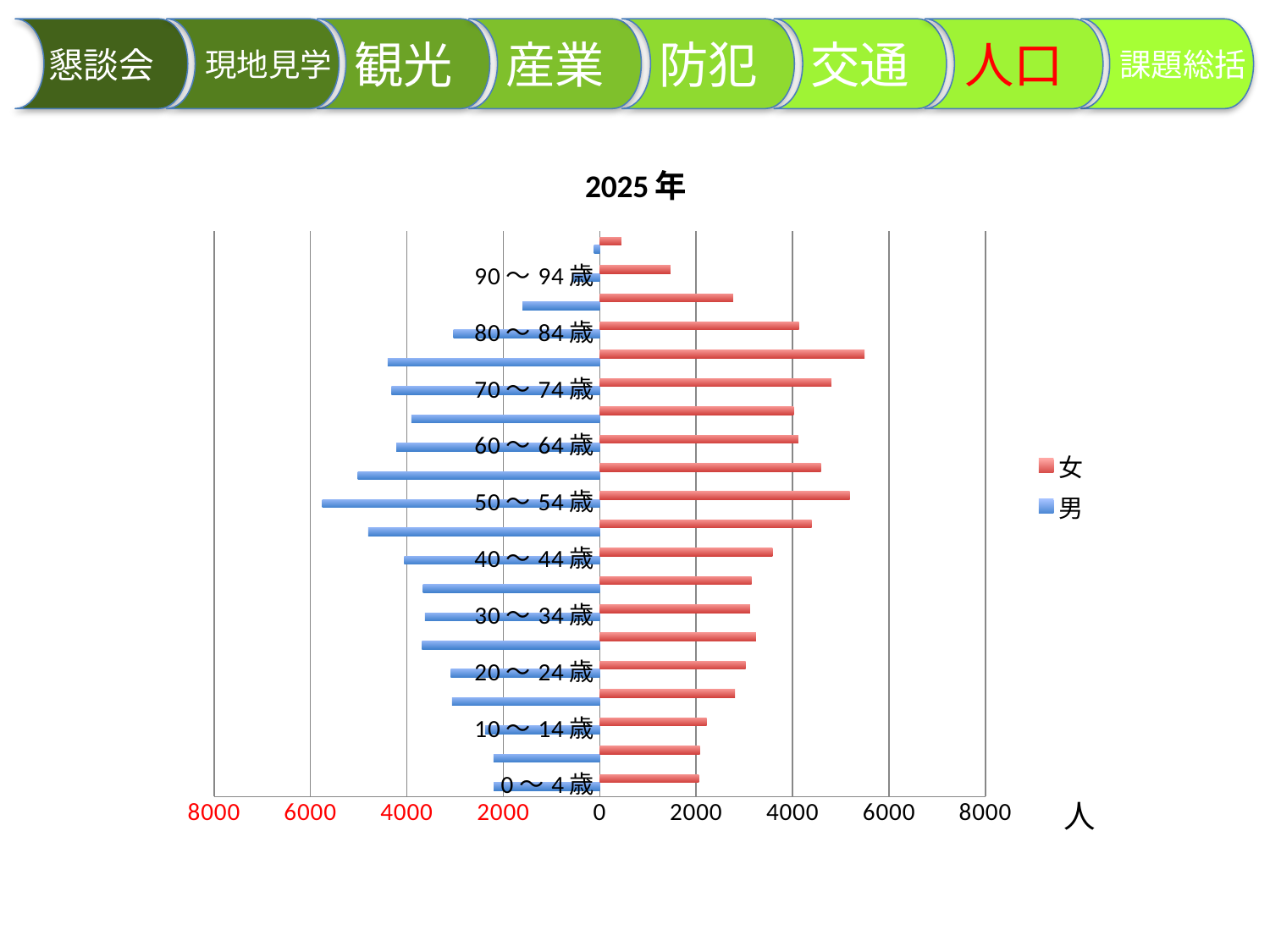
Is the 男 value for 80～84歳 greater or less than 4000? less What is the title of the chart? 2025年 Is the 女 value for 40～44歳 greater or less than 4000? less Which colour represents the 男 series? blue What kind of chart is shown on the slide? bar chart Is the 女 value for 90～94歳 greater or less than 2000? less Which age group has the largest 男 value? 50～54歳 How many series does the legend list? 2 For 90～94歳, which is larger, the 女 value or the 男 value? 女